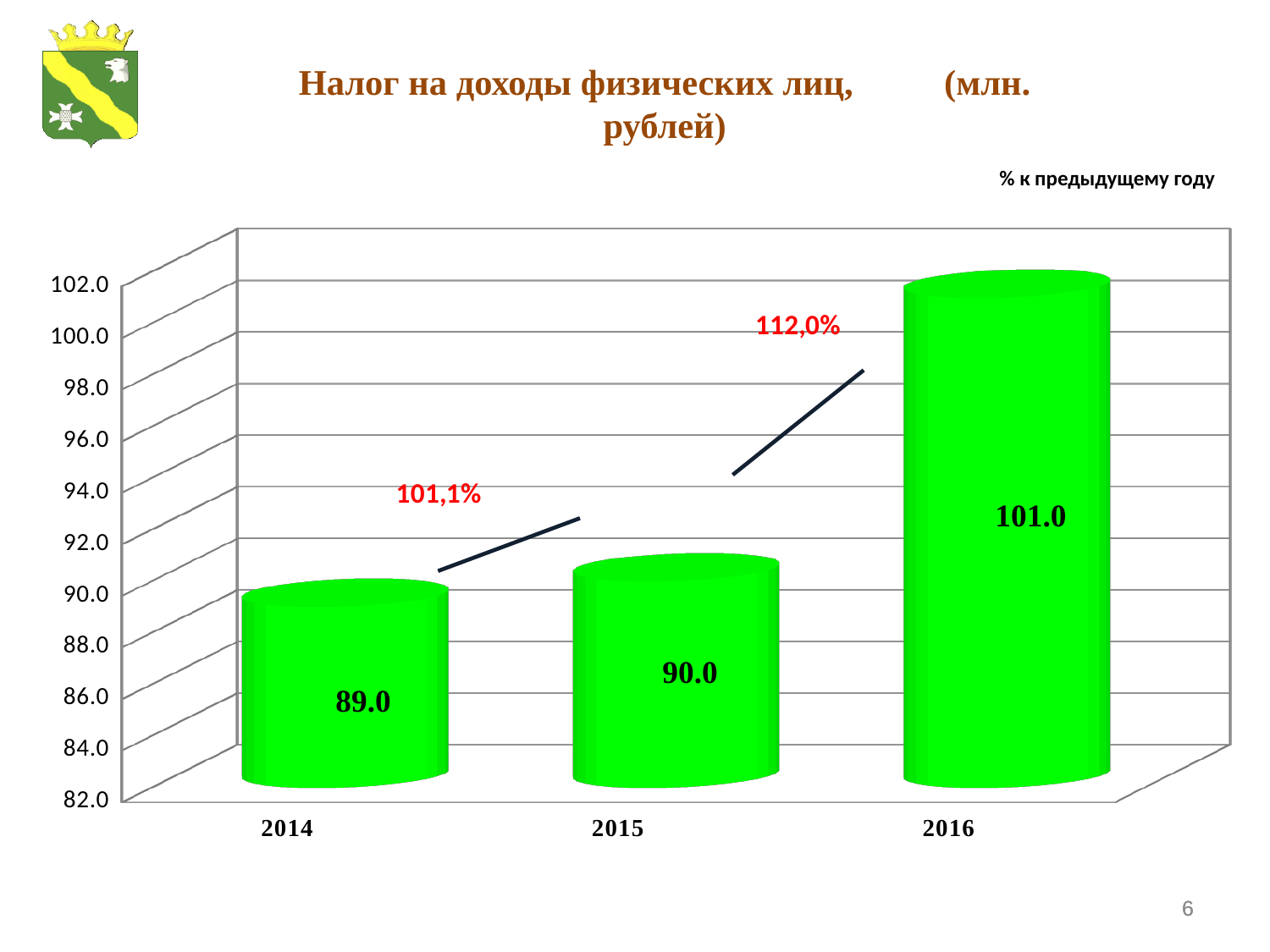
What is the value for 2014? 89.0 What is the value for 2015? 90.0 Which year has the lowest value? 2014 Which is larger, the value for 2016 or the value for 2014? 2016 Do the values rise or fall from 2014 to 2016? rise What is the value for 2016? 101.0 Which year has the highest value? 2016 What is the difference between the values for 2015 and 2014? 1.0 What percentage change relative to the previous year is shown between 2015 and 2016? 112,0% What is the difference between the values for 2016 and 2015? 11.0 How many years are shown on the x axis? 3 What kind of chart is this? bar chart